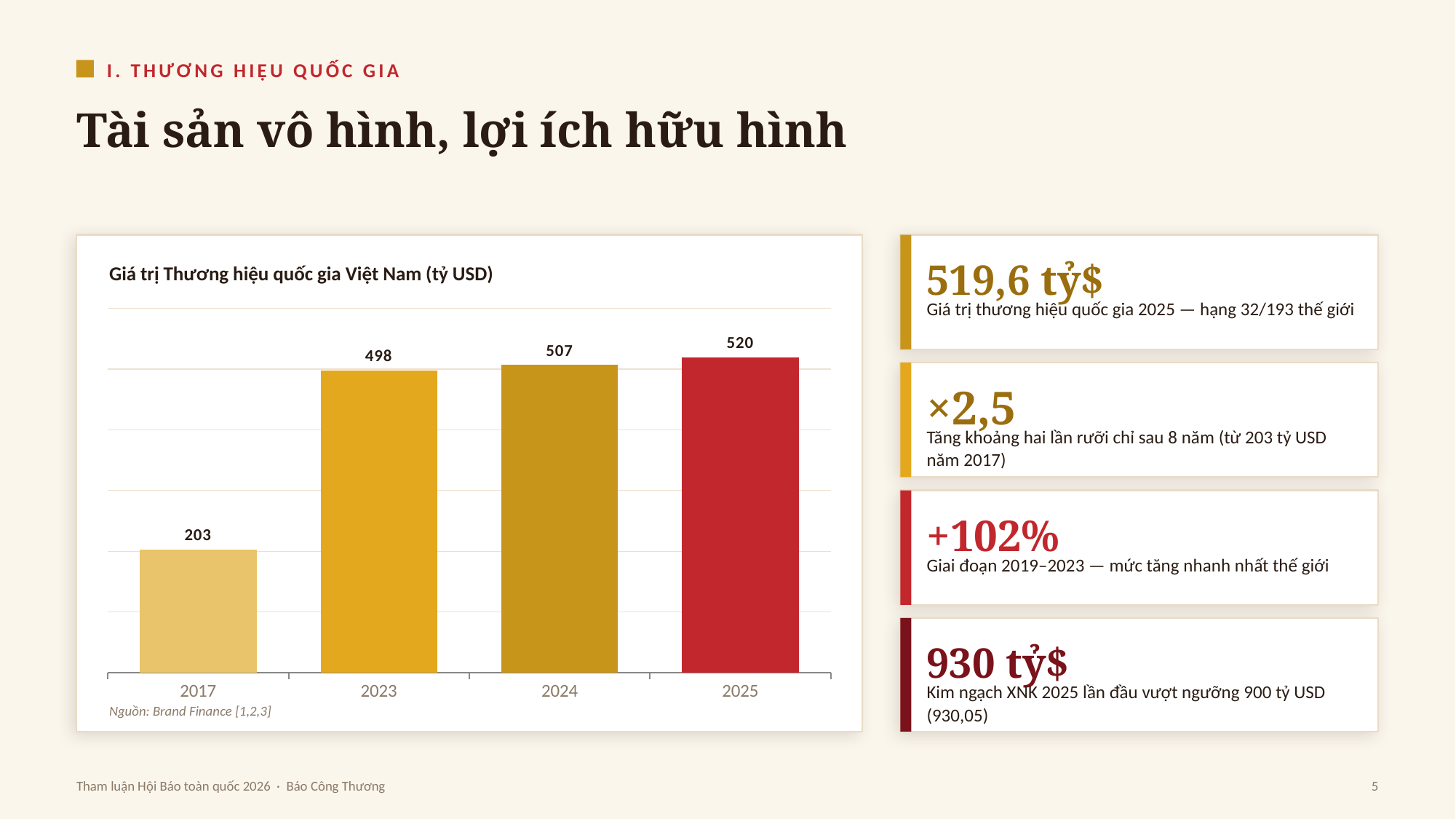
What is the value for 2025 in the chart? 520 Which year has the highest value in the chart? 2025 How many years are shown on the x axis of the chart? 4 What kind of chart is shown on the slide? Bar chart What is the value for 2017 in the chart? 203 What is the difference between the values for 2024 and 2023? 9 Which year has the lowest value in the chart? 2017 Which is larger, the value for 2023 or the value for 2017? 2023 What is the value for 2023 in the chart? 498 What is the title of the chart? Giá trị Thương hiệu quốc gia Việt Nam (tỷ USD) What is the difference between the values for 2025 and 2017? 317 What is the value for 2024 in the chart? 507